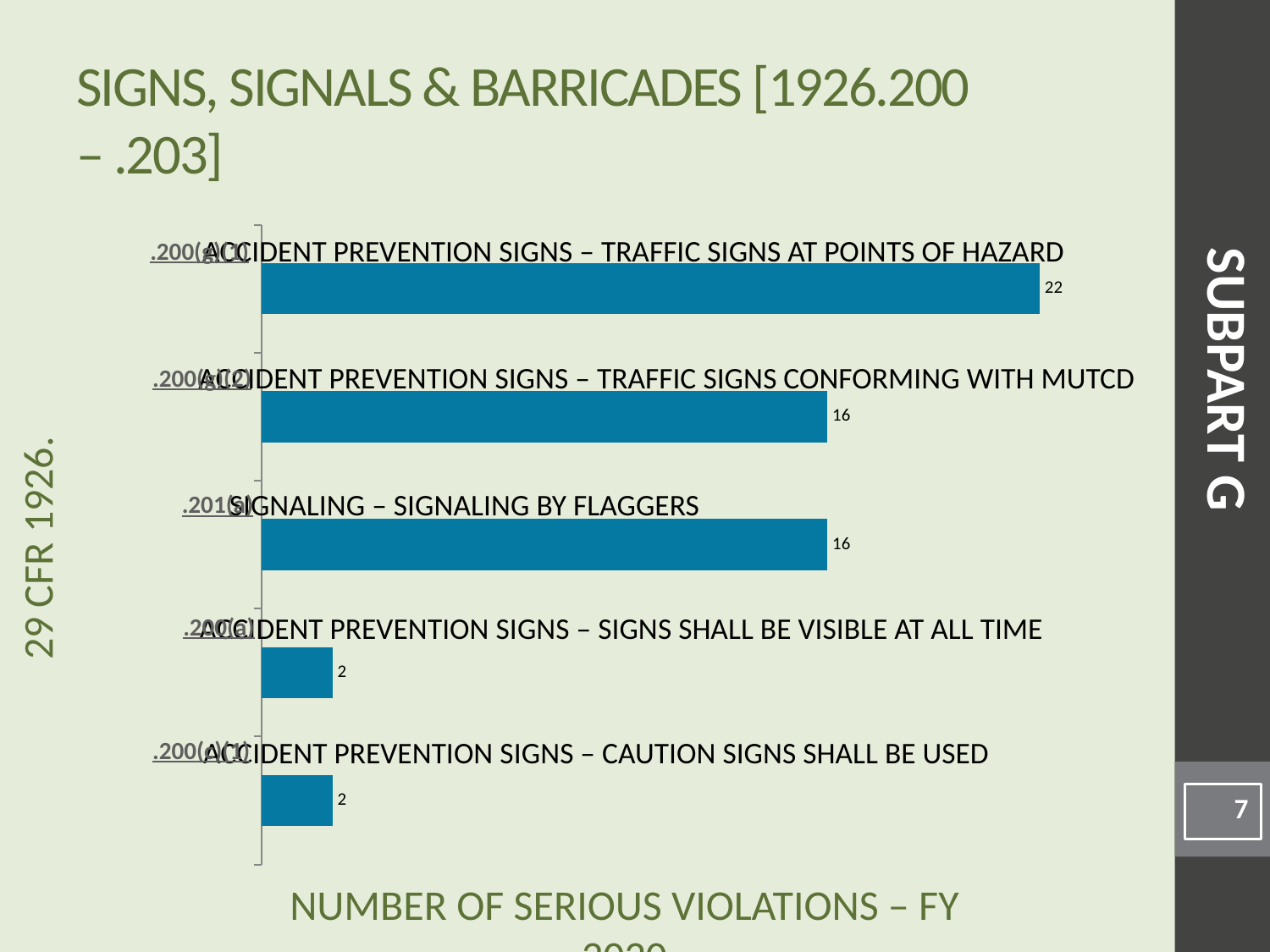
Which has more serious violations: TRAFFIC SIGNS AT POINTS OF HAZARD or SIGNALING BY FLAGGERS? TRAFFIC SIGNS AT POINTS OF HAZARD What is the number of serious violations for ACCIDENT PREVENTION SIGNS – CAUTION SIGNS SHALL BE USED? 2 What is the number of serious violations for SIGNALING – SIGNALING BY FLAGGERS? 16 How many categories are plotted in the chart? 5 How many categories in the chart have a value of 2? 2 What is the number of serious violations for ACCIDENT PREVENTION SIGNS – TRAFFIC SIGNS CONFORMING WITH MUTCD? 16 What is the number of serious violations for ACCIDENT PREVENTION SIGNS – TRAFFIC SIGNS AT POINTS OF HAZARD? 22 What is the difference between the violations for TRAFFIC SIGNS AT POINTS OF HAZARD and TRAFFIC SIGNS CONFORMING WITH MUTCD? 6 What is the difference between the violations for SIGNALING BY FLAGGERS and SIGNS SHALL BE VISIBLE AT ALL TIME? 14 Which category has the highest number of serious violations? ACCIDENT PREVENTION SIGNS – TRAFFIC SIGNS AT POINTS OF HAZARD What colour are the bars in the chart? blue What type of chart is shown on the slide? bar chart